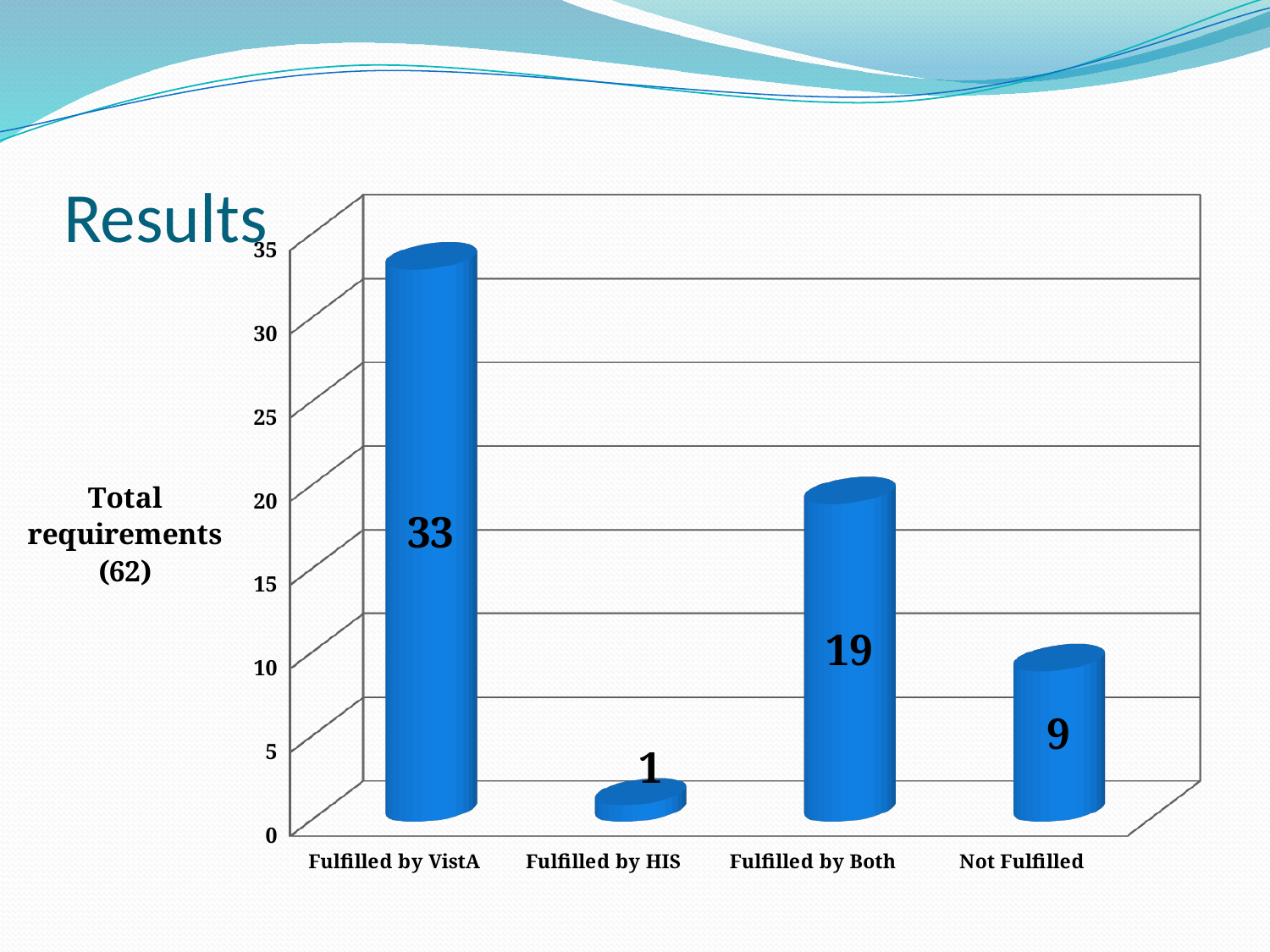
What is the value for Fulfilled by Both? 19 Which category has the highest value? Fulfilled by VistA Which is larger, the value for Not Fulfilled or the value for Fulfilled by HIS? Not Fulfilled What kind of chart is shown on the slide? bar chart What is the value for Not Fulfilled? 9 What is the difference between the values for Fulfilled by Both and Not Fulfilled? 10 What is the difference between the values for Fulfilled by VistA and Fulfilled by Both? 14 What is the value for Fulfilled by VistA? 33 What is the value for Fulfilled by HIS? 1 Which category has the lowest value? Fulfilled by HIS How many categories are shown on the x axis? 4 What is the total number of requirements stated in the label to the left of the chart? 62